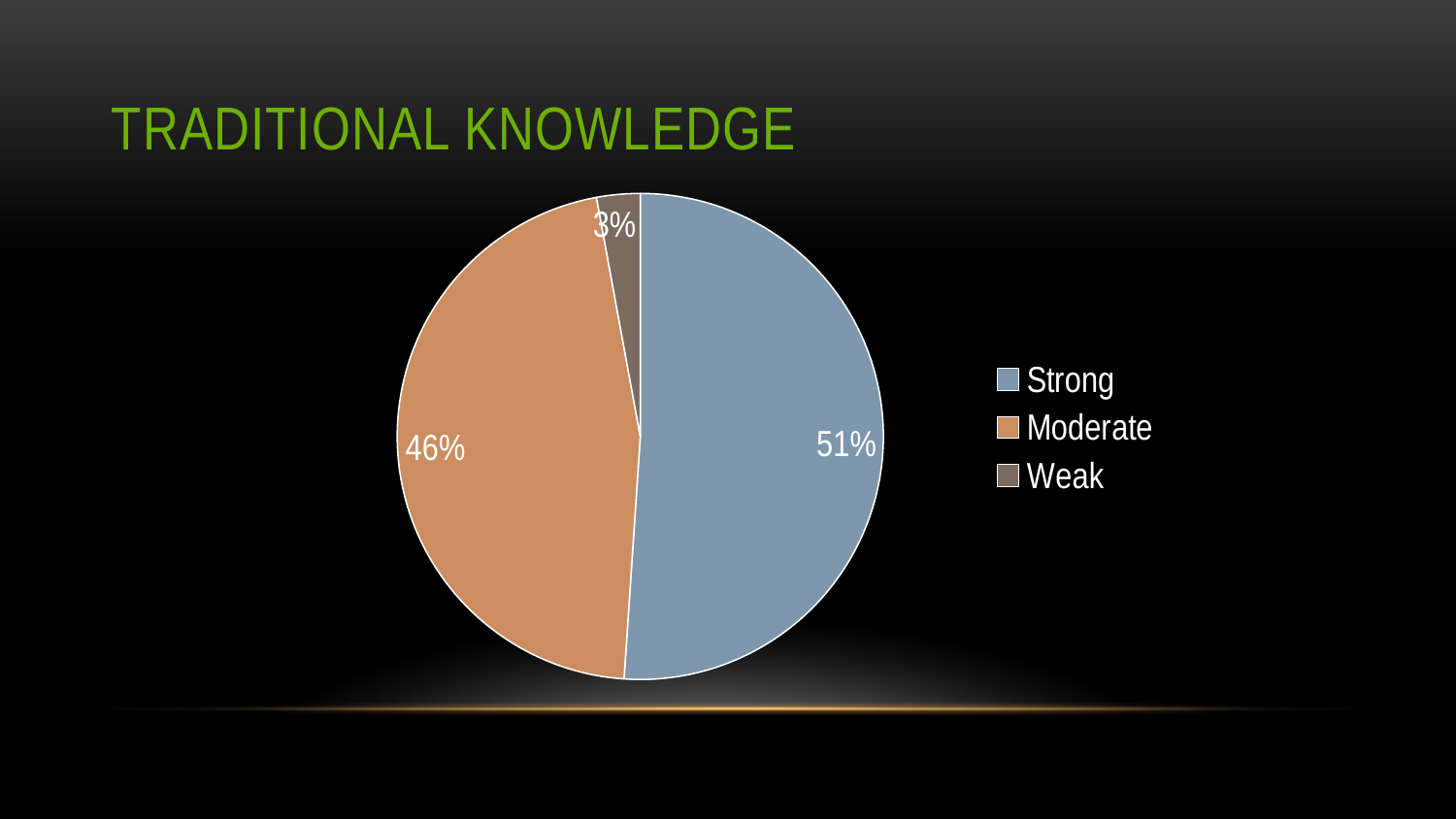
What percentage of the pie is labelled Weak? 3% What percentage of the pie is labelled Moderate? 46% Which slice is larger, Strong or Moderate? Strong Which category has the smallest share of the pie? Weak What is the difference in percentage points between the Moderate and Weak slices? 43 Which category has the largest share of the pie? Strong What kind of chart is shown on the slide? pie chart What is the title of the chart? TRADITIONAL KNOWLEDGE What colour is the Moderate slice? orange What is the difference in percentage points between the Strong and Moderate slices? 5 How many categories does the legend list? 3 What percentage of the pie is labelled Strong? 51%